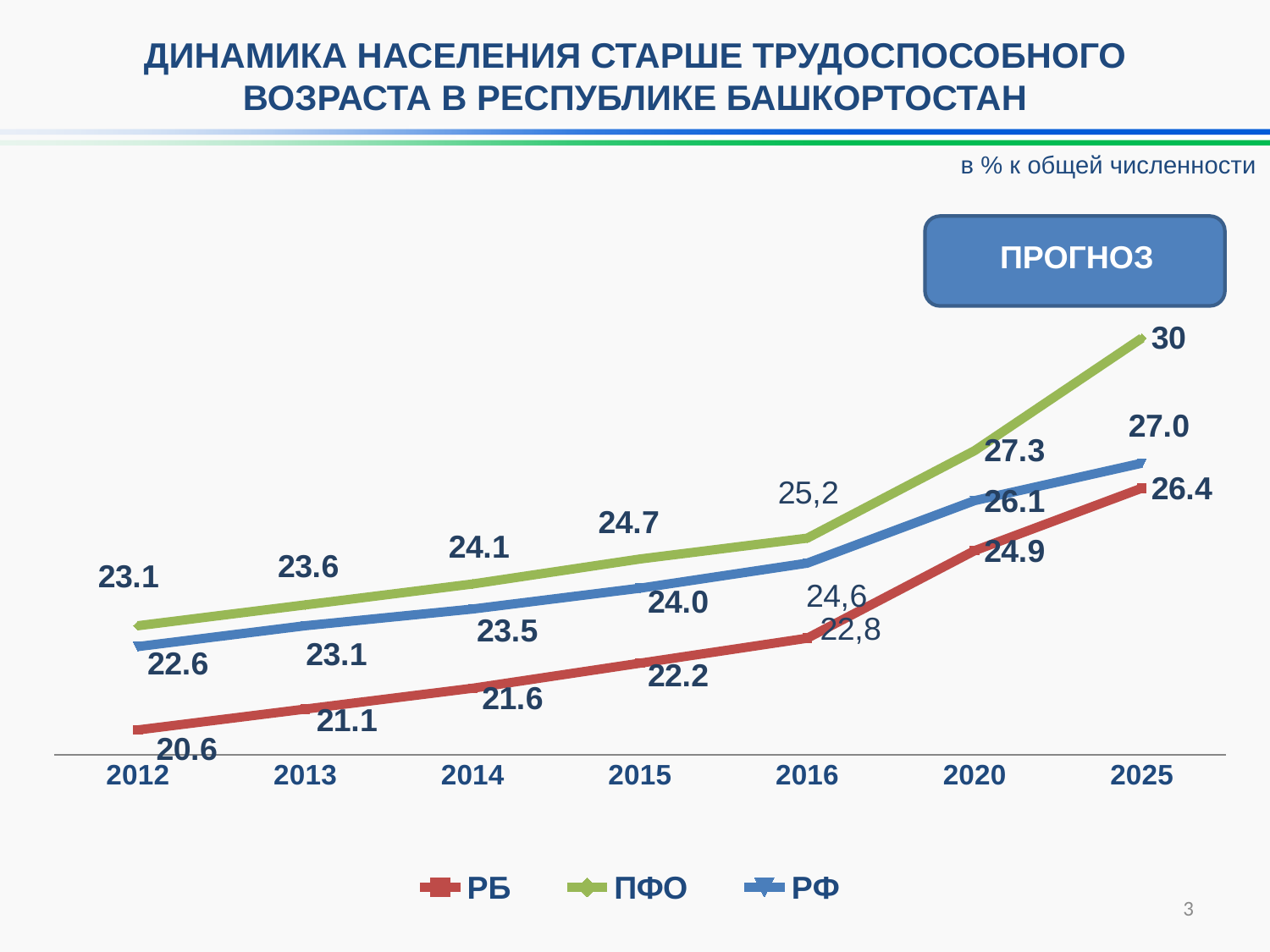
Which is larger in 2020, the value for РФ or the value for РБ? РФ What is the difference between the ПФО and РБ values in 2025? 3.6 What kind of chart is shown on the slide? line chart Which series has the highest value in 2025? ПФО What is the value for ПФО in 2025? 30 How many years are shown on the x axis? 7 What is the value for РБ in 2012? 20.6 How many series does the legend list? 3 What is the value for РФ in 2016? 24,6 Do the values for РБ rise or fall from 2012 to 2025? rise Which series has the lowest value in 2012? РБ What is the value for РБ in 2020? 24.9